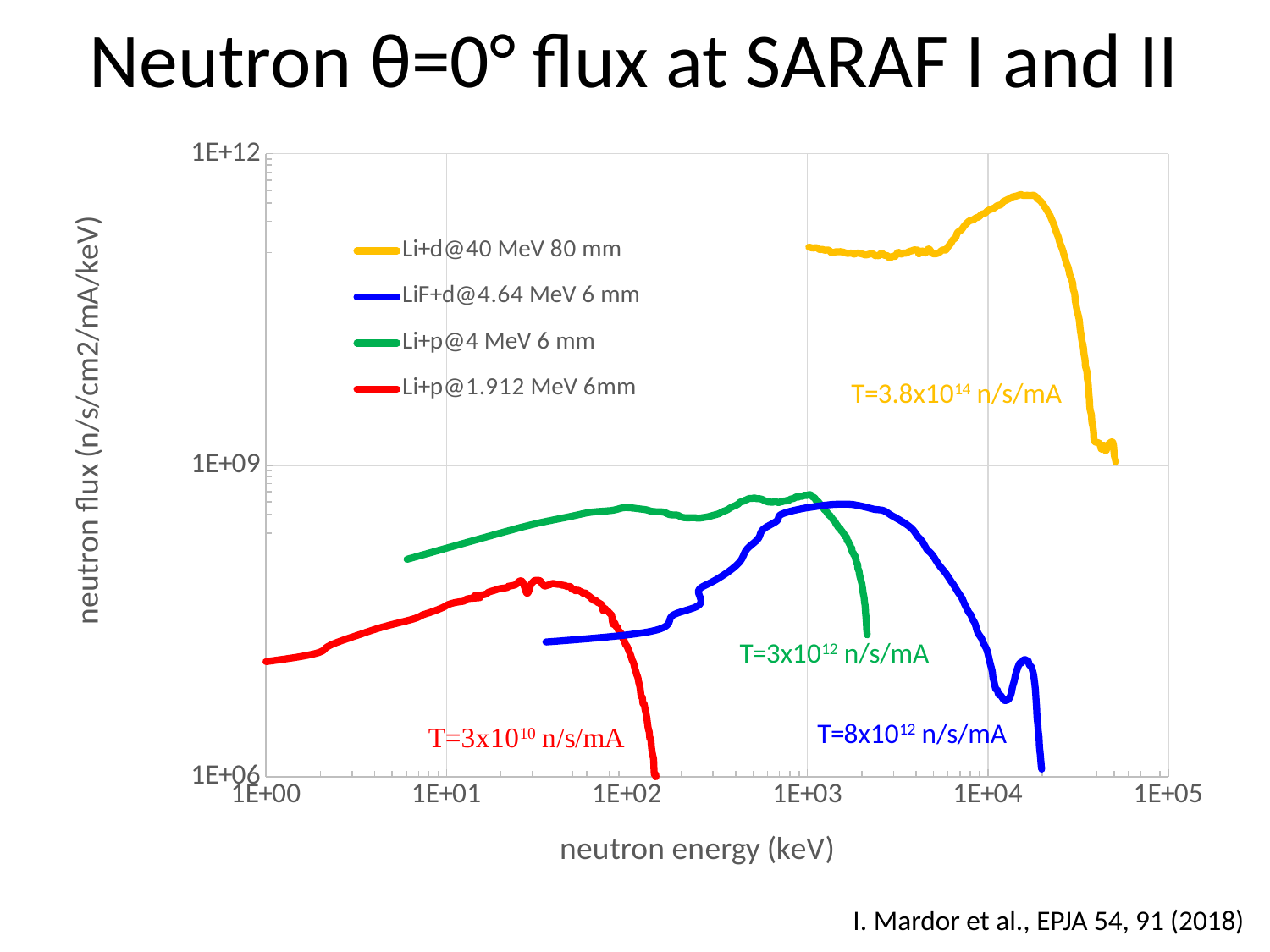
Which colour is used for the Li+p@4 MeV 6 mm series? green What kind of chart is shown on the slide? line chart Is the peak neutron flux of the Li+d@40 MeV 80 mm curve greater or less than 1E+09? greater Which series reaches the highest neutron flux on the chart? Li+d@40 MeV 80 mm What total neutron yield T is annotated for the LiF+d@4.64 MeV 6 mm curve? T=8x10^12 n/s/mA What is the title of the chart? Neutron θ=0° flux at SARAF I and II What total neutron yield T is annotated for the Li+d@40 MeV 80 mm curve? T=3.8x10^14 n/s/mA What total neutron yield T is annotated for the Li+p@1.912 MeV 6mm curve? T=3x10^10 n/s/mA Which series has the lowest peak neutron flux? Li+p@1.912 MeV 6mm How many series does the legend list? 4 Which has the larger annotated total yield T, LiF+d@4.64 MeV 6 mm or Li+p@4 MeV 6 mm? LiF+d@4.64 MeV 6 mm